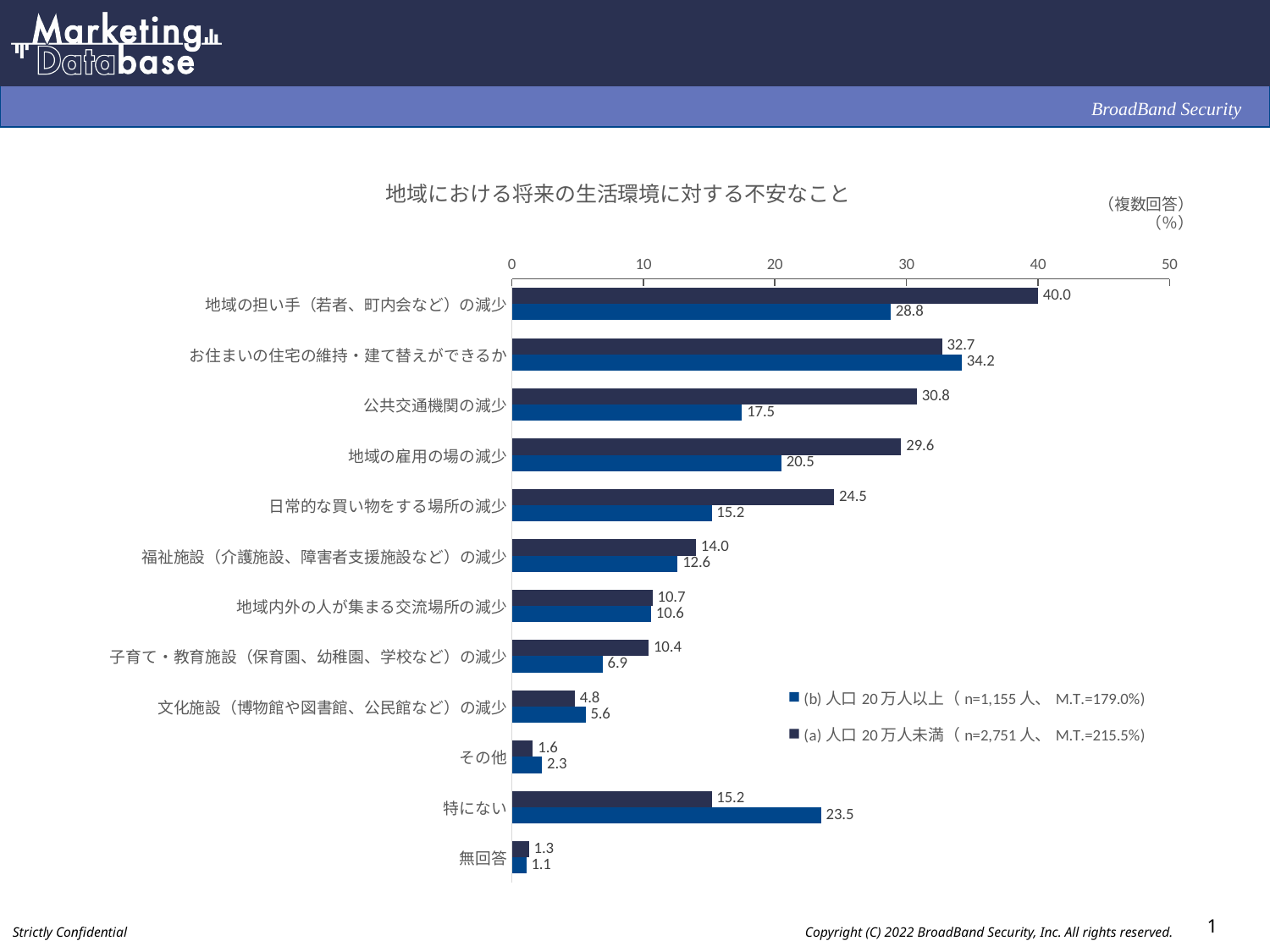
Which category has the highest value in the (b) 人口20万人以上 series? お住まいの住宅の維持・建て替えができるか What type of chart is shown on the slide? bar chart How many categories are plotted on the chart? 12 How many series does the legend list? 2 For お住まいの住宅の維持・建て替えができるか, which series has the larger value, (b) 人口20万人以上 or (a) 人口20万人未満? (b) 人口20万人以上 What is the value for 地域の担い手（若者、町内会など）の減少 in the (b) 人口20万人以上 series? 28.8 What is the value for 特にない in the (a) 人口20万人未満 series? 15.2 What is the title of the chart? 地域における将来の生活環境に対する不安なこと Which category has the lowest value in the (a) 人口20万人未満 series? 無回答 Is the value for 日常的な買い物をする場所の減少 in the (b) 人口20万人以上 series greater or less than 20? less What is the value for 公共交通機関の減少 in the (a) 人口20万人未満 series? 30.8 What is the difference between the (b) 人口20万人以上 and (a) 人口20万人未満 values for 地域の雇用の場の減少? 9.1